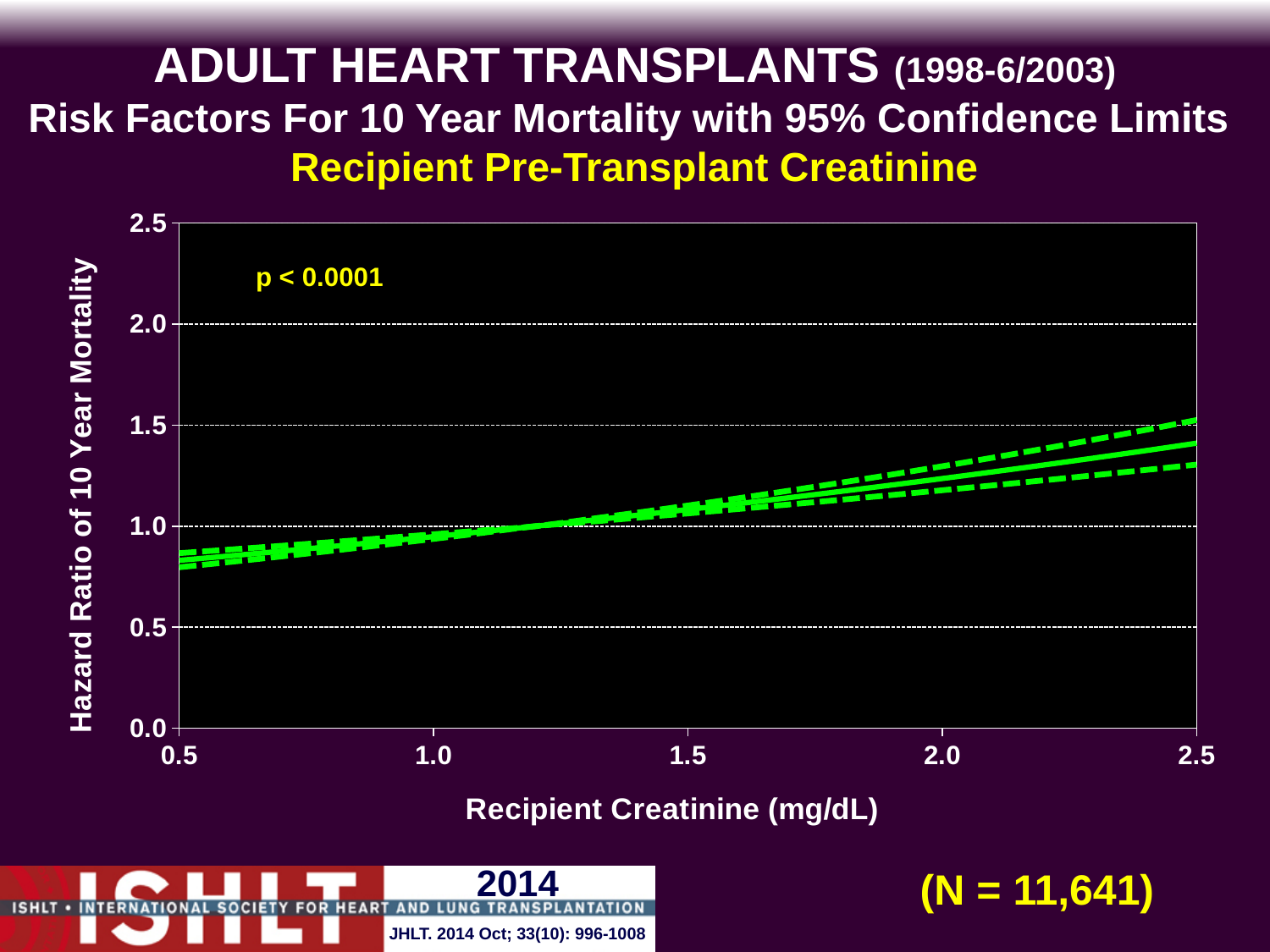
Is the hazard ratio (solid line) at a recipient creatinine of 2.0 mg/dL greater or less than 1.5? less Does the hazard ratio of 10 year mortality rise or fall as recipient creatinine increases from 0.5 to 2.5 mg/dL? rise Is the hazard ratio at a recipient creatinine of 0.5 mg/dL greater or less than 0.5? greater What is the label of the x axis? Recipient Creatinine (mg/dL) Is the hazard ratio at a recipient creatinine of 0.5 mg/dL greater or less than 1.0? less How many lines are plotted on the chart (the estimate plus its confidence limits)? 3 What p-value is printed on the chart? p < 0.0001 What kind of chart is shown on the slide? line chart Which has the higher hazard ratio: a recipient creatinine of 1.0 mg/dL or 2.0 mg/dL? 2.0 mg/dL